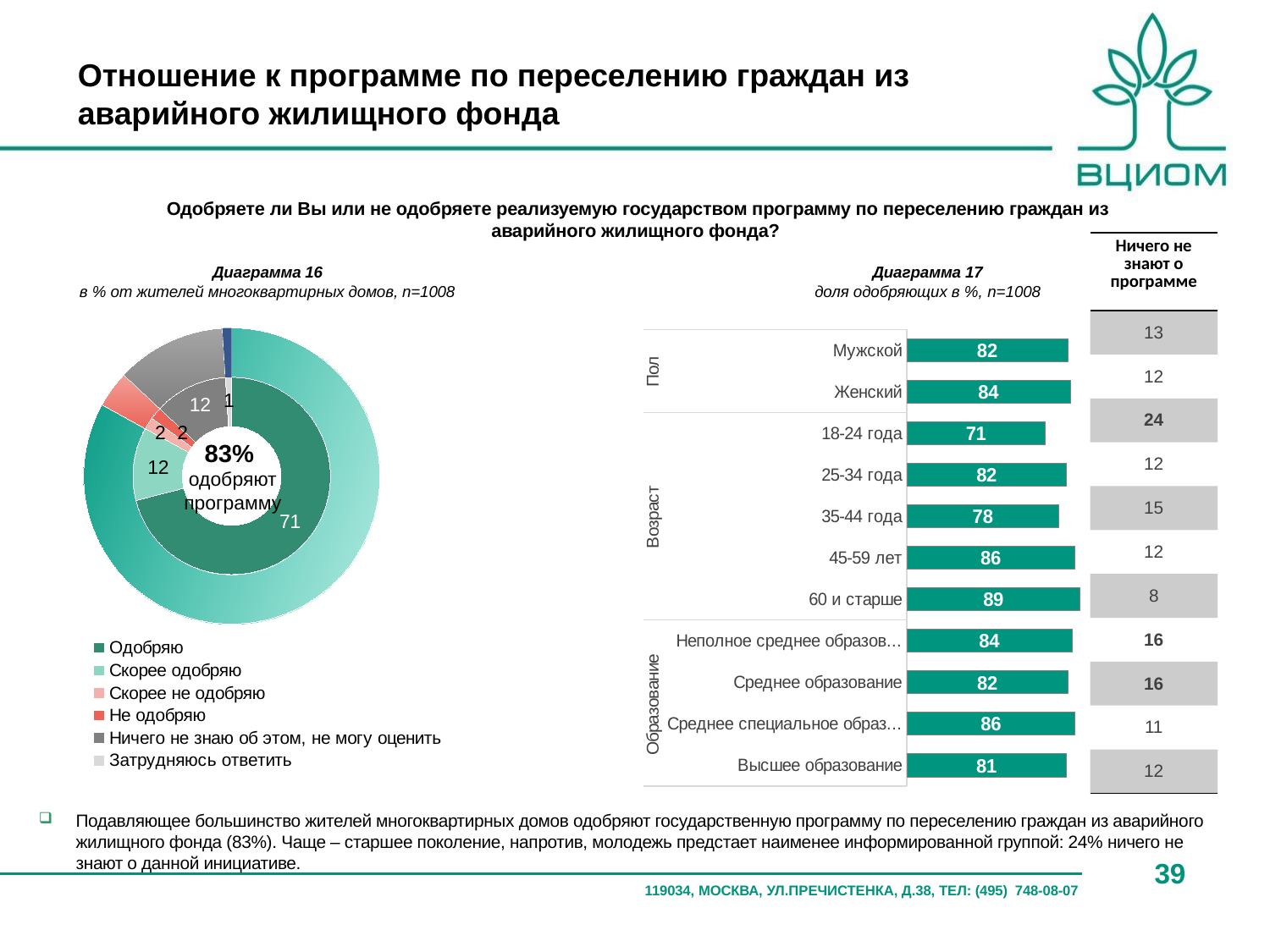
In Диаграмма 17, which category has the highest share of approving respondents? 60 и старше How many categories (bars) are shown in Диаграмма 17? 11 What percentage is shown in the centre of Диаграмма 16 as approving the programme? 83% In Диаграмма 17, which category has the lowest share of approving respondents? 18-24 года In Диаграмма 17, what is the share of approving respondents among men (Мужской)? 82 What type of chart is Диаграмма 17? Bar chart In Диаграмма 16, what percentage of respondents chose Ничего не знаю об этом, не могу оценить? 12 In Диаграмма 16, what percentage of respondents chose Одобряю? 71 In Диаграмма 17, what is the difference between the values for 60 и старше and 18-24 года? 18 In Диаграмма 17, what is the value for the 60 и старше age group? 89 In Диаграмма 17, which is larger: the value for Женский or the value for Мужской? Женский How many entries does the legend of Диаграмма 16 list? 6